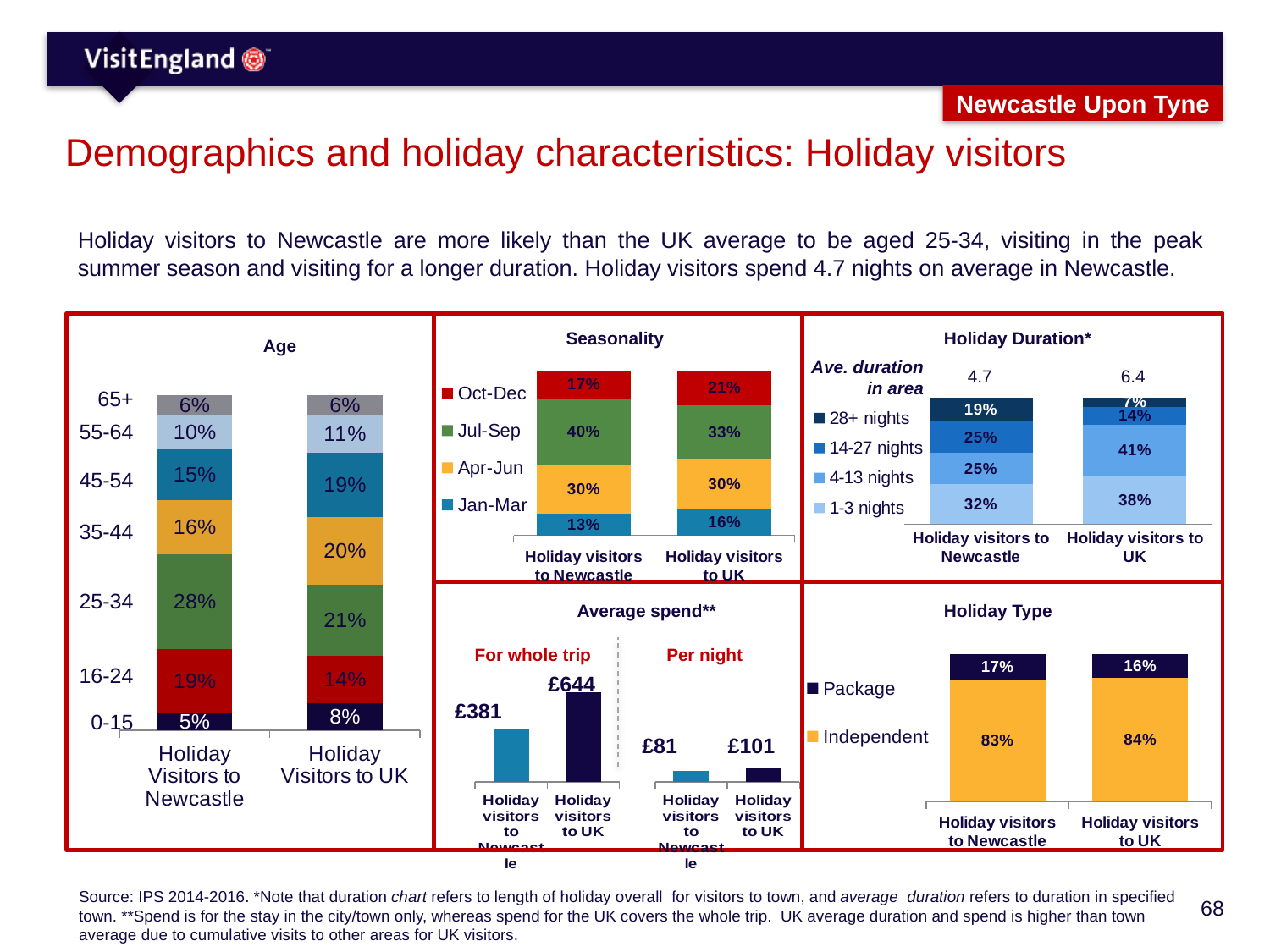
In the Holiday Duration chart, what is the average duration in area for holiday visitors to UK? 6.4 In the Seasonality chart, what share of holiday visitors to Newcastle visit in Jul-Sep? 40% In the Average spend chart, what is the difference in per night spend between holiday visitors to UK and holiday visitors to Newcastle? £20 In the Average spend chart, what is the spend for the whole trip for holiday visitors to UK? £644 In the Holiday Type chart, what share of holiday visitors to Newcastle are on a package holiday? 17% In the Holiday Duration chart, what share of holiday visitors to Newcastle stay 1-3 nights? 32% How many series does the legend of the Seasonality chart list? 4 In the Age chart, what share of holiday visitors to Newcastle are aged 25-34? 28% In the Seasonality chart, which is larger: the Oct-Dec share for holiday visitors to Newcastle or for holiday visitors to UK? Holiday visitors to UK In the Age chart, which age group is the largest for holiday visitors to Newcastle? 25-34 What kind of chart is the Holiday Type chart? Stacked bar chart In the Age chart, what is the difference between the 16-24 share for holiday visitors to Newcastle and for holiday visitors to UK? 5%